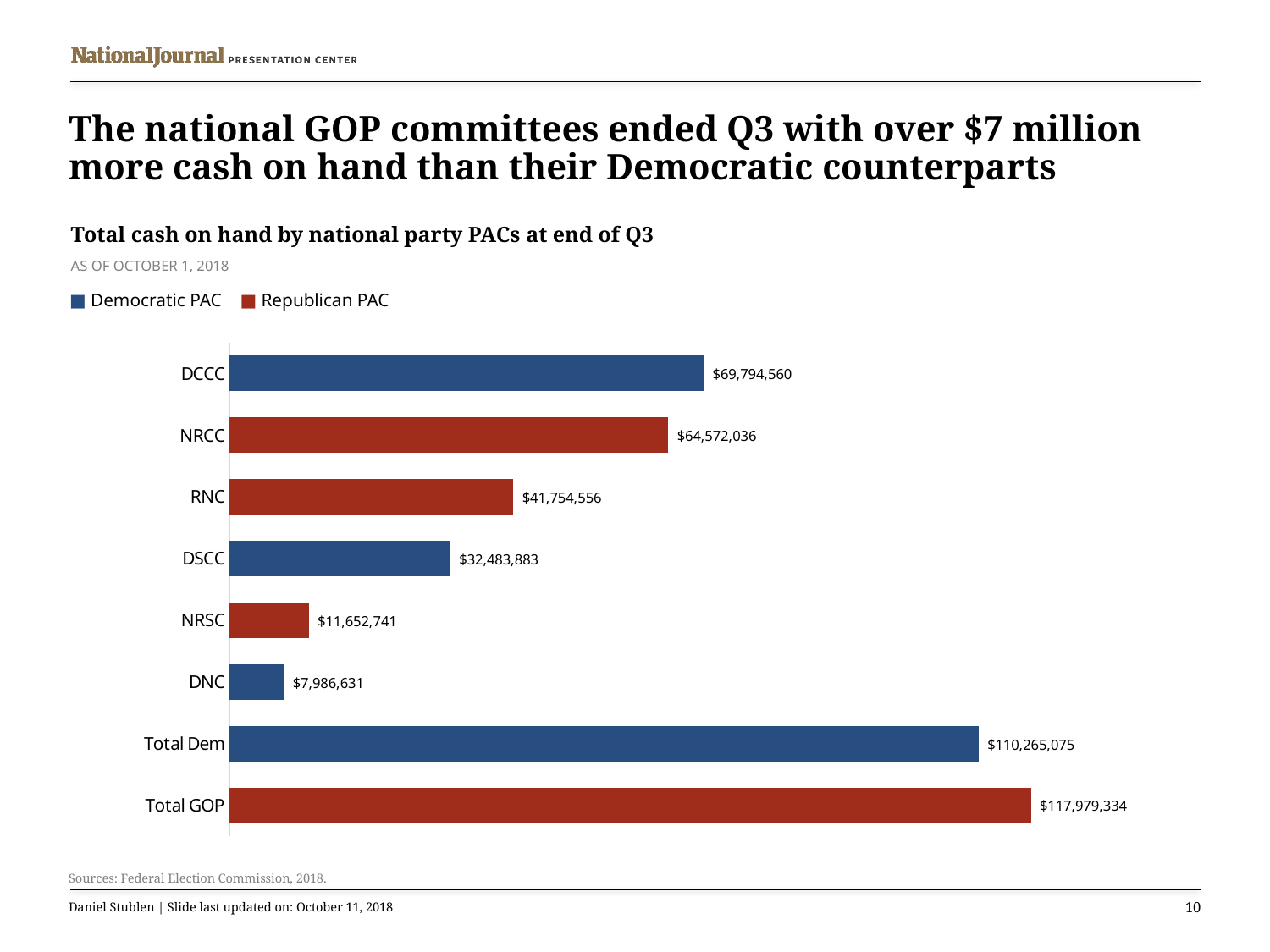
Which has more cash on hand, the RNC or the DSCC? RNC What is the difference between Total GOP and Total Dem cash on hand? $7,714,259 What is the total cash on hand for the DCCC? $69,794,560 Which category has the lowest cash on hand? DNC How many bars are shown in the chart? 8 Which category has the highest cash on hand? Total GOP How much more cash on hand does the DCCC have than the NRCC? $5,222,524 Among the individual committees (excluding the totals), which has the most cash on hand? DCCC What type of chart is shown on the slide? Bar chart How many series does the legend list? 2 What is the total cash on hand for the NRSC? $11,652,741 What is the value shown for Total GOP? $117,979,334